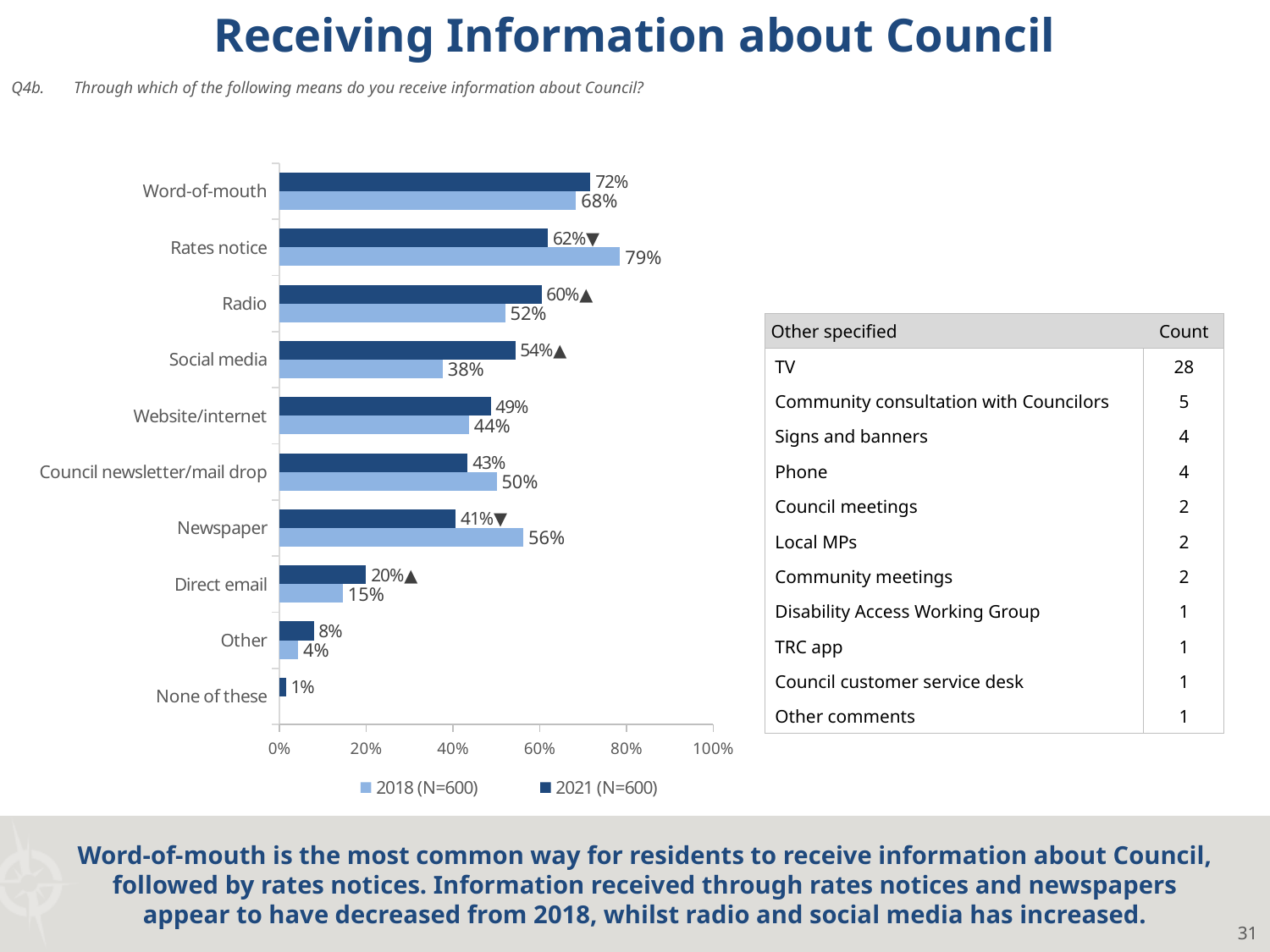
What is the difference between the 2018 and 2021 values for newspaper? 15% How many series does the legend list? 2 Which category has the highest value for the 2018 series? Rates notice What are the two series listed in the chart legend? 2018 (N=600) and 2021 (N=600) Which category has the lowest value for the 2021 series? None of these Which category has the highest value for the 2021 series? Word-of-mouth What type of chart is shown on the slide? Bar chart What percentage of residents received information about Council through word-of-mouth in 2021? 72% What percentage received information via social media in 2018? 38% How many categories are shown on the chart? 10 Which is larger for radio: the 2018 value or the 2021 value? 2021 What was the 2018 value for rates notice? 79%